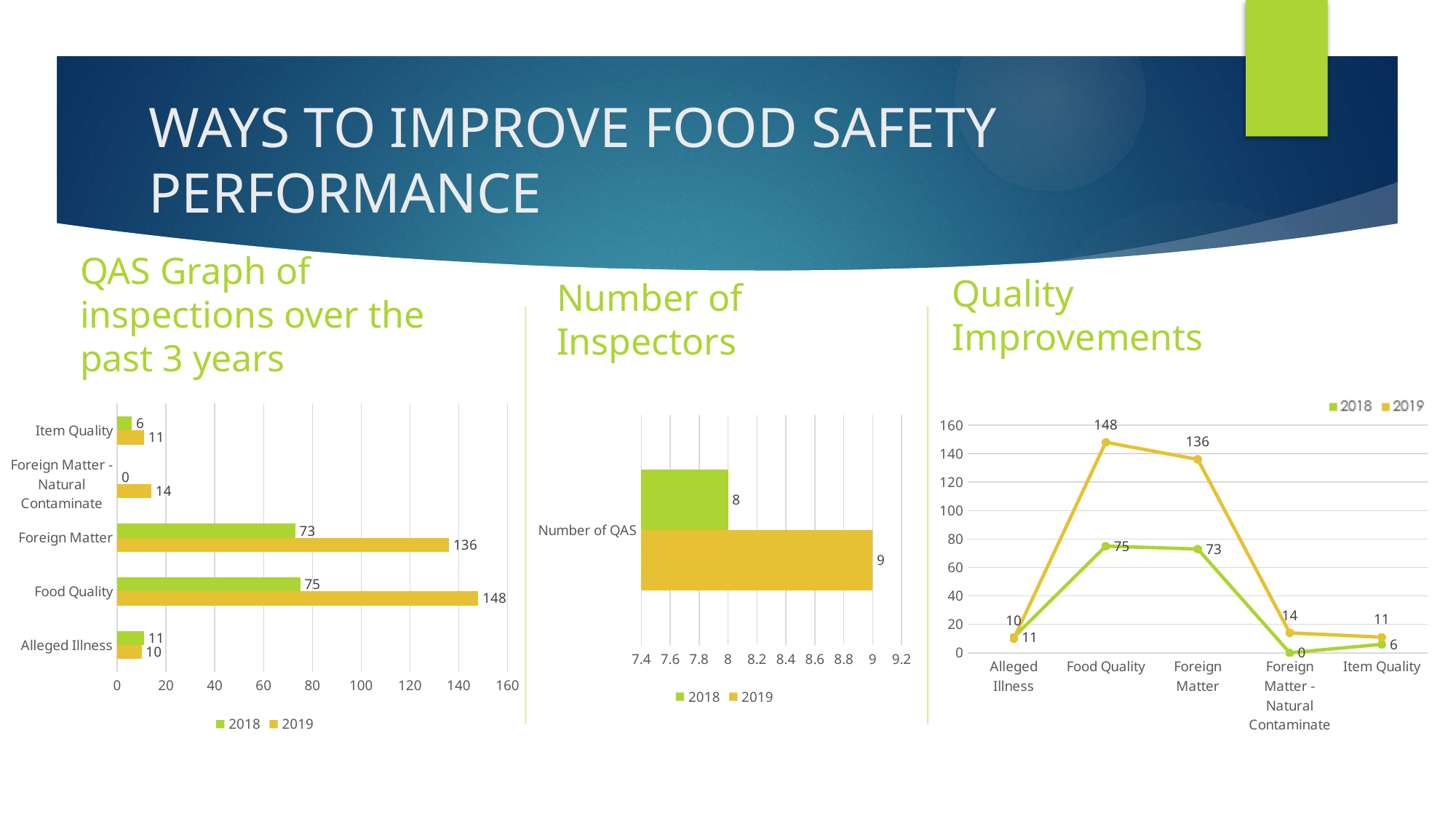
How many series does the legend of the 'Quality Improvements' chart list? 2 What kind of chart is the 'Number of Inspectors' chart? Bar chart In the 'Number of Inspectors' chart, what is the Number of QAS for 2019? 9 In the 'QAS Graph of inspections over the past 3 years' chart, what is the difference between the 2019 and 2018 values for Foreign Matter? 63 In the 'QAS Graph of inspections over the past 3 years' chart, how many categories are shown on the vertical axis? 5 In the 'QAS Graph of inspections over the past 3 years' chart, what is the 2019 value for Food Quality? 148 In the 'QAS Graph of inspections over the past 3 years' chart, what is the 2018 value for Foreign Matter? 73 What kind of chart is the 'Quality Improvements' chart? Line chart In the 'Quality Improvements' chart, what is the 2019 value for Foreign Matter - Natural Contaminate? 14 In the 'QAS Graph of inspections over the past 3 years' chart, which category has the lowest 2018 value? Foreign Matter - Natural Contaminate In the 'Number of Inspectors' chart, which year has the larger Number of QAS, 2018 or 2019? 2019 In the 'QAS Graph of inspections over the past 3 years' chart, which category has the highest 2019 value? Food Quality